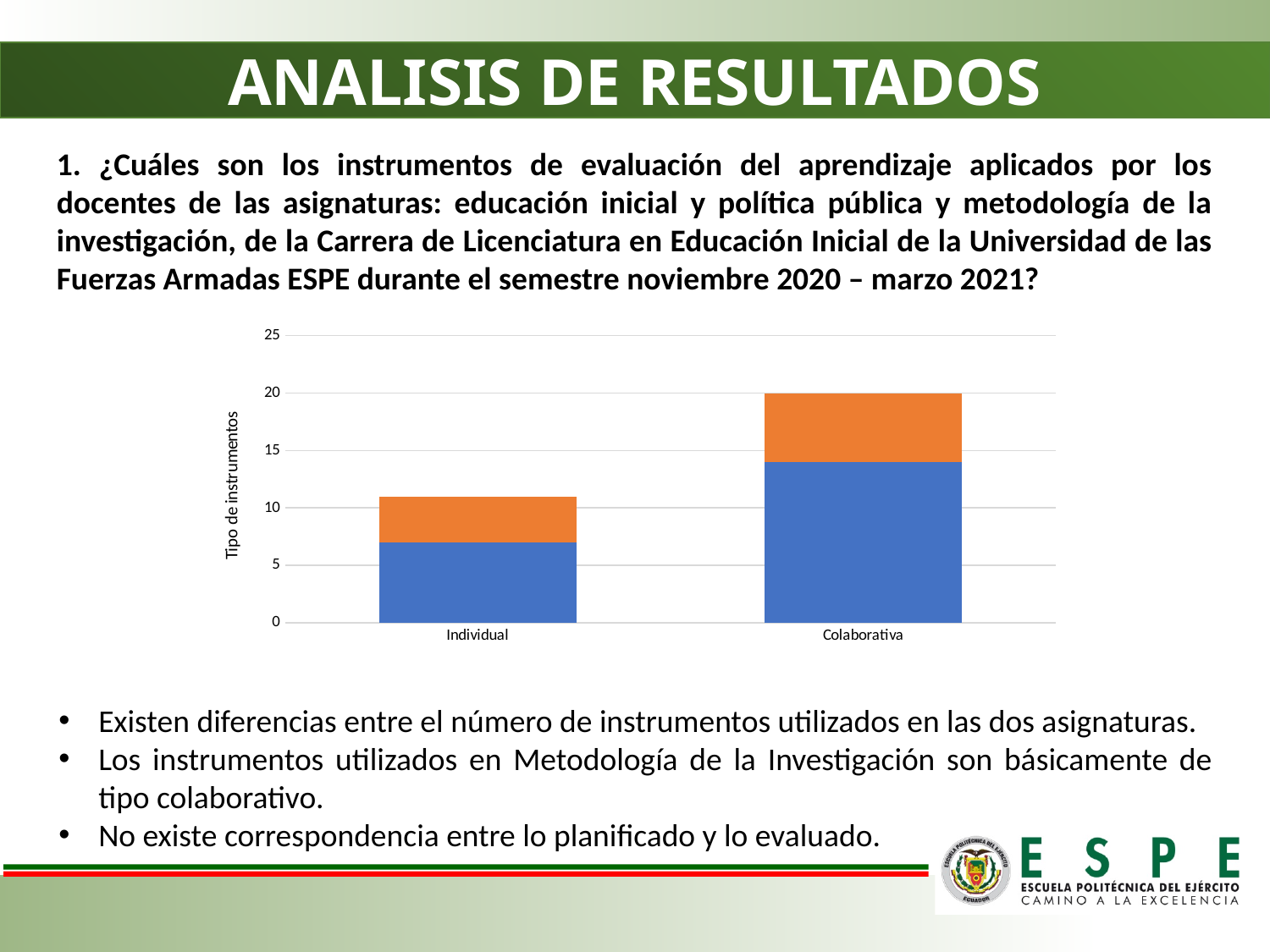
What is the total height of the Colaborativa stacked bar? 20 Which stacked bar is taller, Individual or Colaborativa? Colaborativa Which category has the tallest stacked bar in the chart? Colaborativa Is the blue segment of the Individual bar greater or less than 10? less Is the total height of the Colaborativa stacked bar greater or less than 15? greater Is the total height of the Individual stacked bar greater or less than 15? less How many categories are shown on the x axis of the chart? 2 What two colours are used for the segments of the stacked bars? blue and orange What is the title of the vertical axis of the chart? Tipo de instrumentos What kind of chart is shown on the slide? bar chart Which category has the shortest stacked bar in the chart? Individual